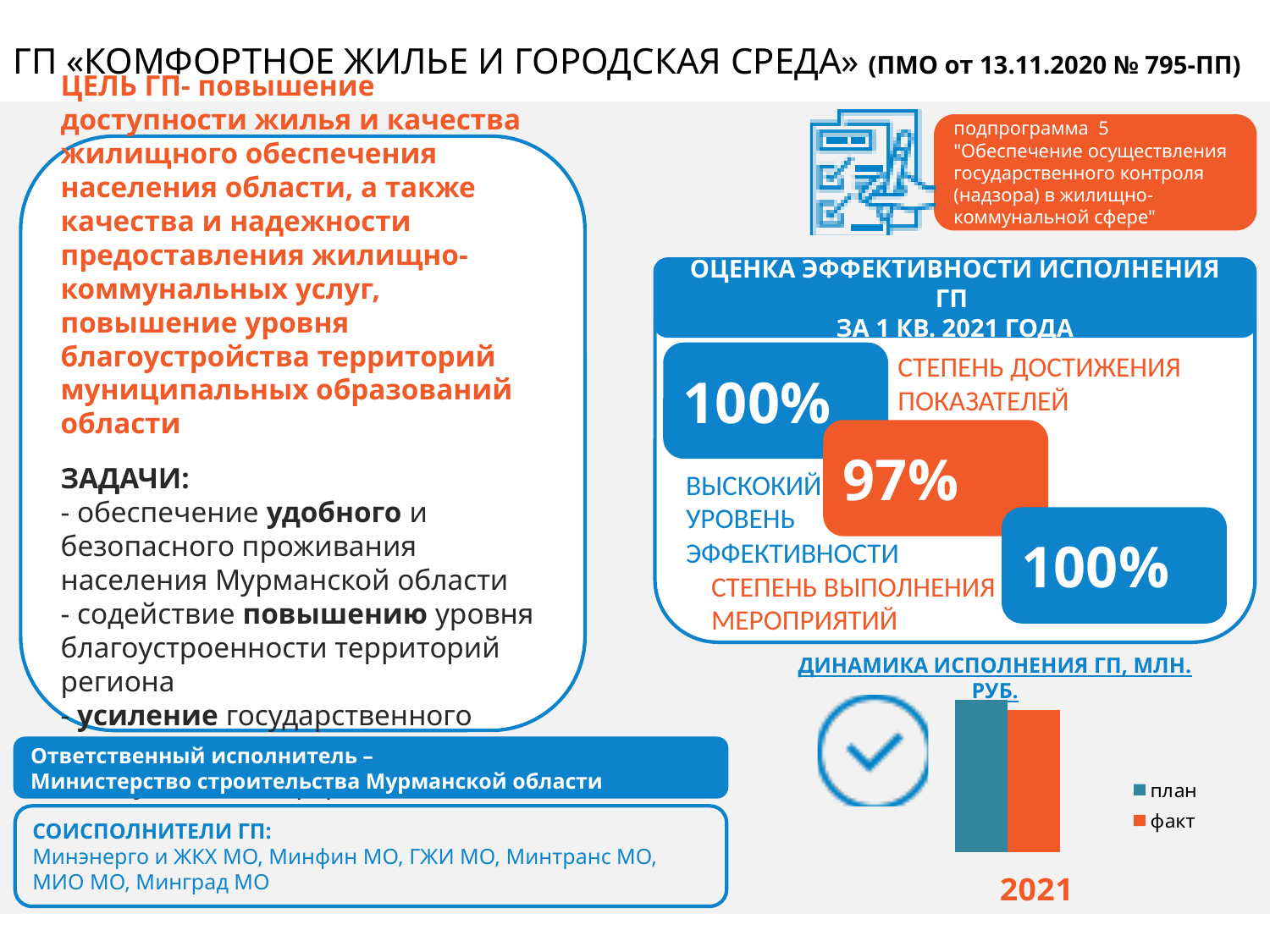
What kind of chart is shown under the heading «ДИНАМИКА ИСПОЛНЕНИЯ ГП, МЛН. РУБ.»? bar chart In the «ДИНАМИКА ИСПОЛНЕНИЯ ГП» chart, which bar is taller for 2021, план or факт? план What are the two legend entries of the «ДИНАМИКА ИСПОЛНЕНИЯ ГП» chart? план, факт How many categories are shown on the x axis of the «ДИНАМИКА ИСПОЛНЕНИЯ ГП» chart? 1 How many series does the legend of the «ДИНАМИКА ИСПОЛНЕНИЯ ГП» chart list? 2 Which year is shown on the x axis of the «ДИНАМИКА ИСПОЛНЕНИЯ ГП» chart? 2021